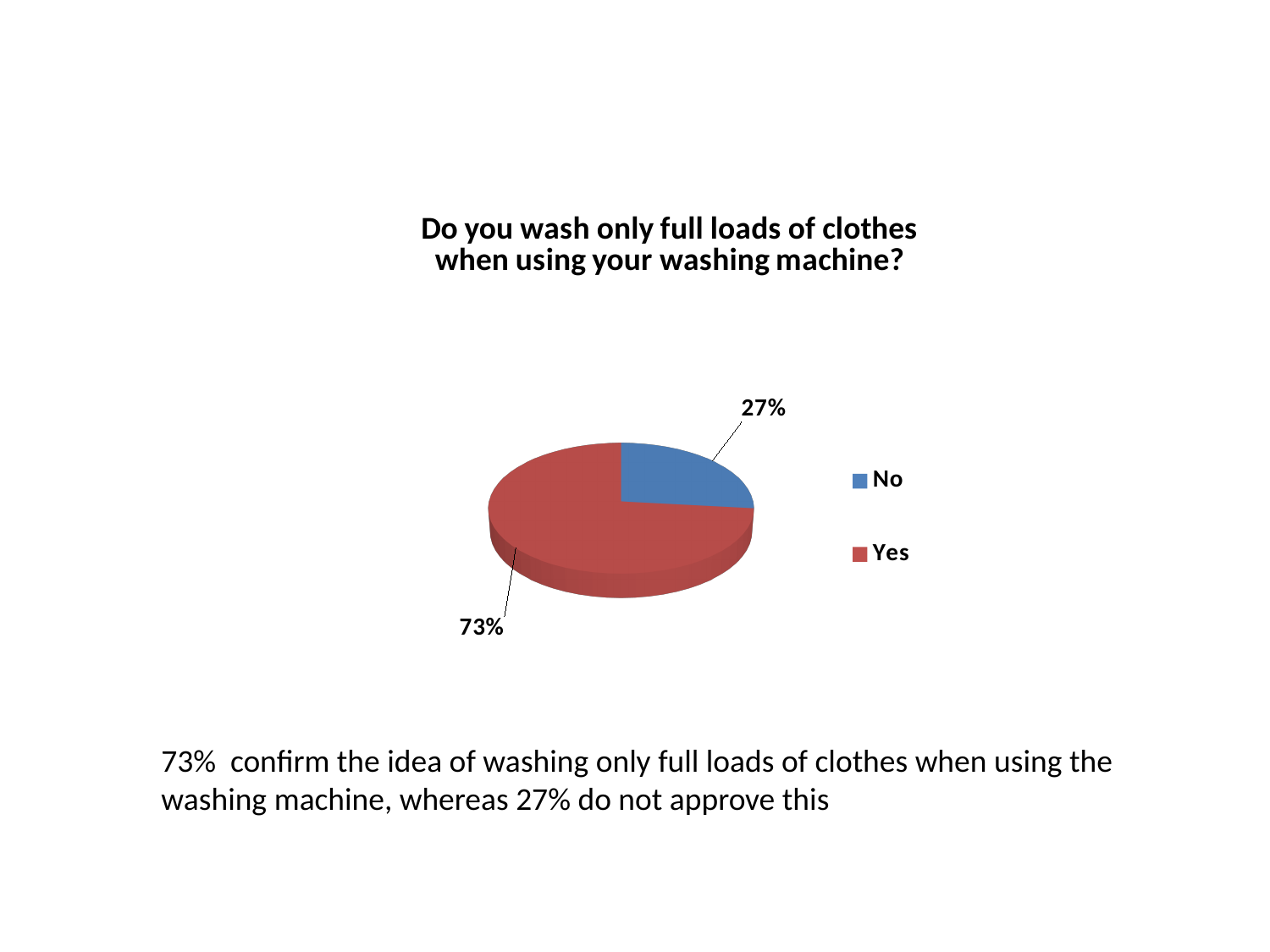
What is the difference in percentage points between the "Yes" and "No" slices? 46 Which is larger, the "Yes" slice or the "No" slice? Yes How many entries does the legend list? 2 What colour is the "No" slice of the pie? Blue What kind of chart is shown on the slide? Pie chart What share of the pie is labelled "Yes"? 73% Which slice of the pie is the smallest? No What is the title of the chart? Do you wash only full loads of clothes when using your washing machine? What share of the pie is labelled "No"? 27% Which slice of the pie is the largest? Yes How many slices does the pie chart have? 2